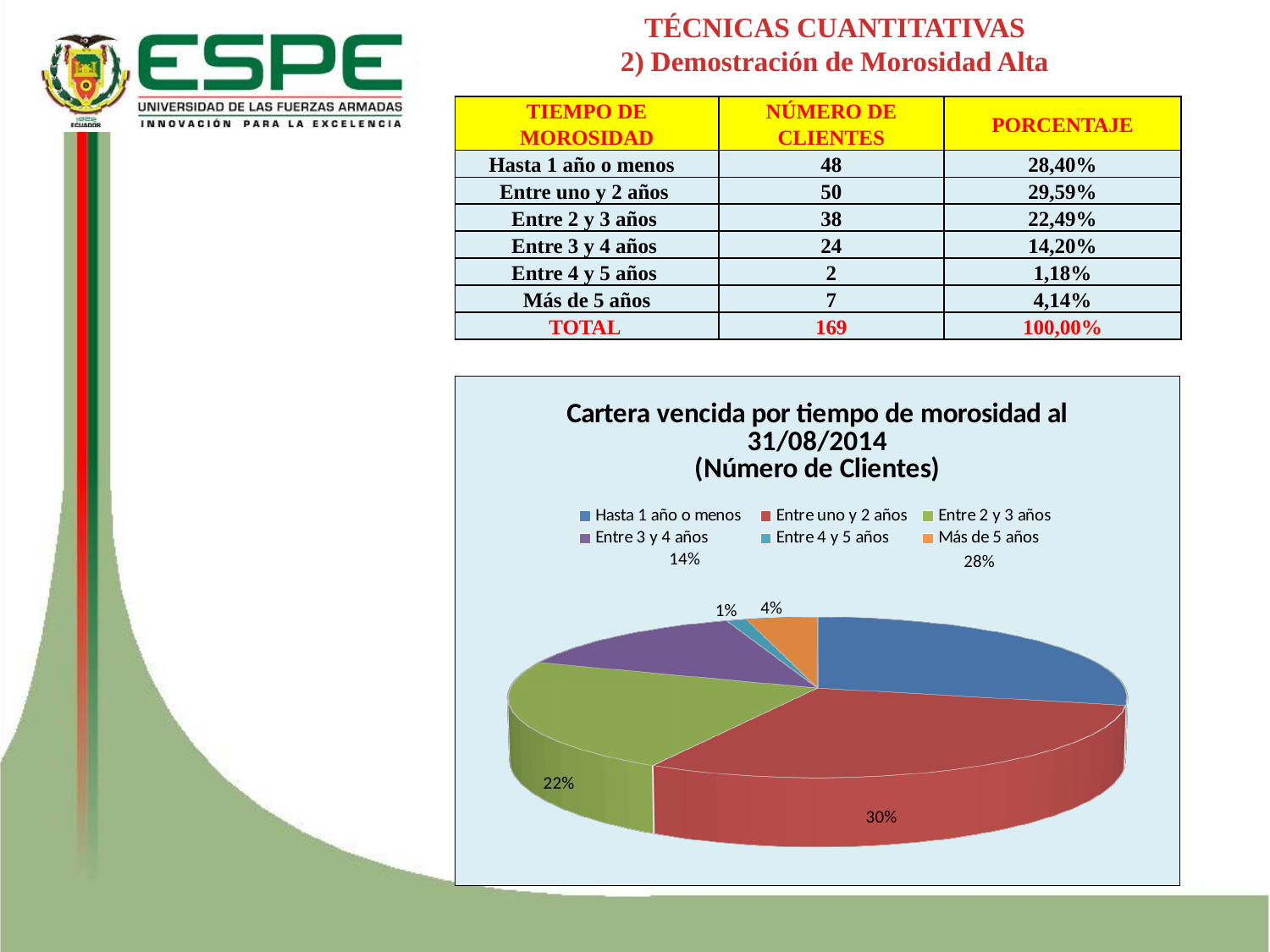
In the pie chart, which slice is larger: "Entre 2 y 3 años" or "Entre 3 y 4 años"? Entre 2 y 3 años What kind of chart is shown on the slide? Pie chart What percentage label is shown on the pie slice for "Más de 5 años"? 4% What percentage label is shown on the pie slice for "Entre 3 y 4 años"? 14% Which category has the largest slice in the pie chart? Entre uno y 2 años What percentage label is shown on the pie slice for "Entre 4 y 5 años"? 1% What percentage label is shown on the pie slice for "Entre uno y 2 años"? 30% What is the title of the pie chart? Cartera vencida por tiempo de morosidad al 31/08/2014 (Número de Clientes) How many categories does the legend of the pie chart list? 6 Which category has the smallest slice in the pie chart? Entre 4 y 5 años What percentage label is shown on the pie slice for "Entre 2 y 3 años"? 22% What percentage label is shown on the pie slice for "Hasta 1 año o menos"? 28%